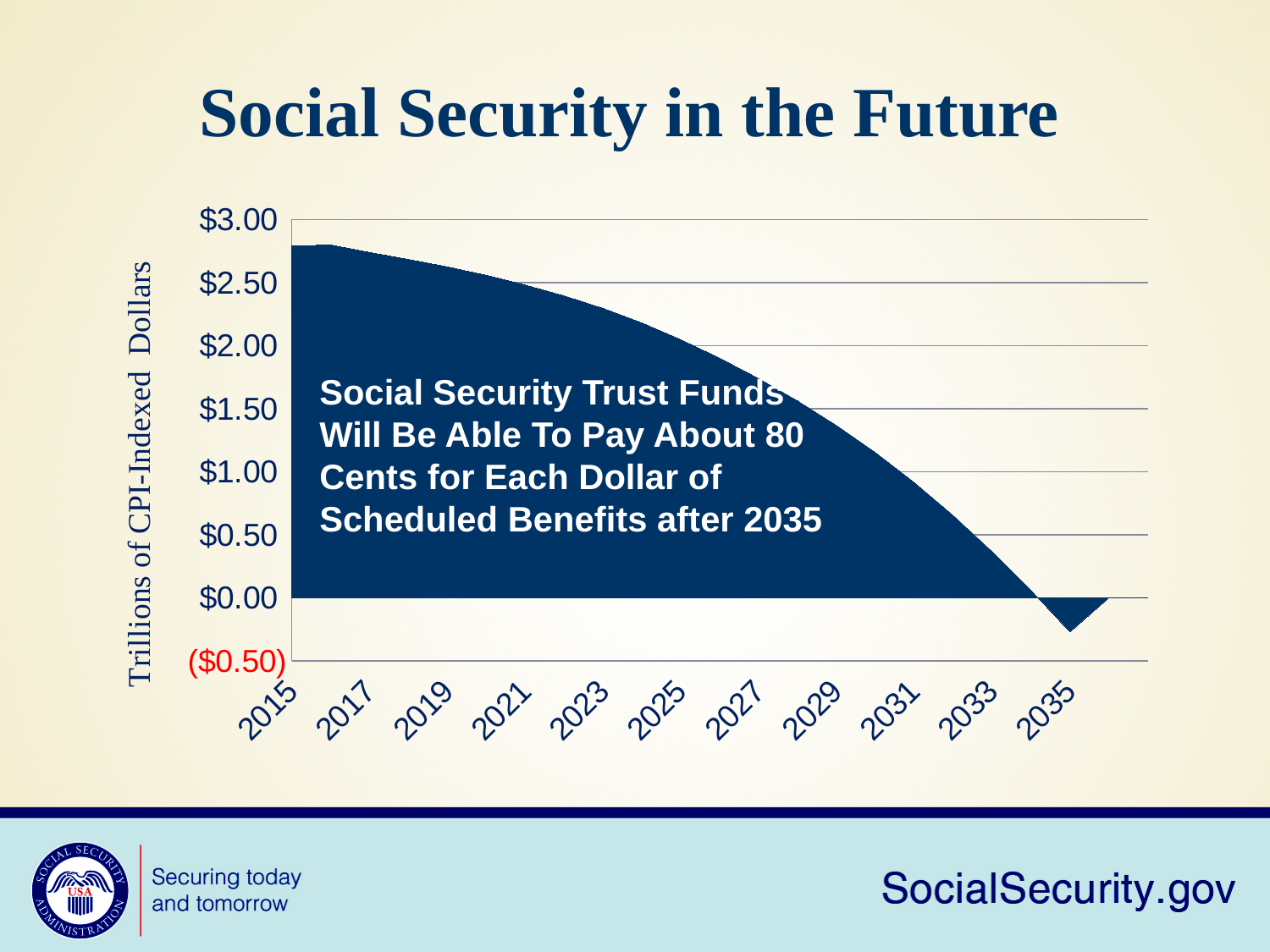
Which is larger, the value for 2019 or the value for 2031? 2019 What is the label on the vertical axis? Trillions of CPI-Indexed Dollars Is the value for 2029 greater or less than $1.50? less Do the values rise or fall from 2015 to 2035? fall What kind of chart is shown on the slide? area chart According to the text on the chart, about how many cents for each dollar of scheduled benefits will the trust funds be able to pay after 2035? About 80 cents Is the value for 2033 greater or less than $1.00? less Which year on the x axis has the lowest value? 2035 Which is larger, the value for 2015 or the value for 2035? 2015 Is the value for 2015 greater or less than $2.50? greater How many year labels are shown on the x axis? 11